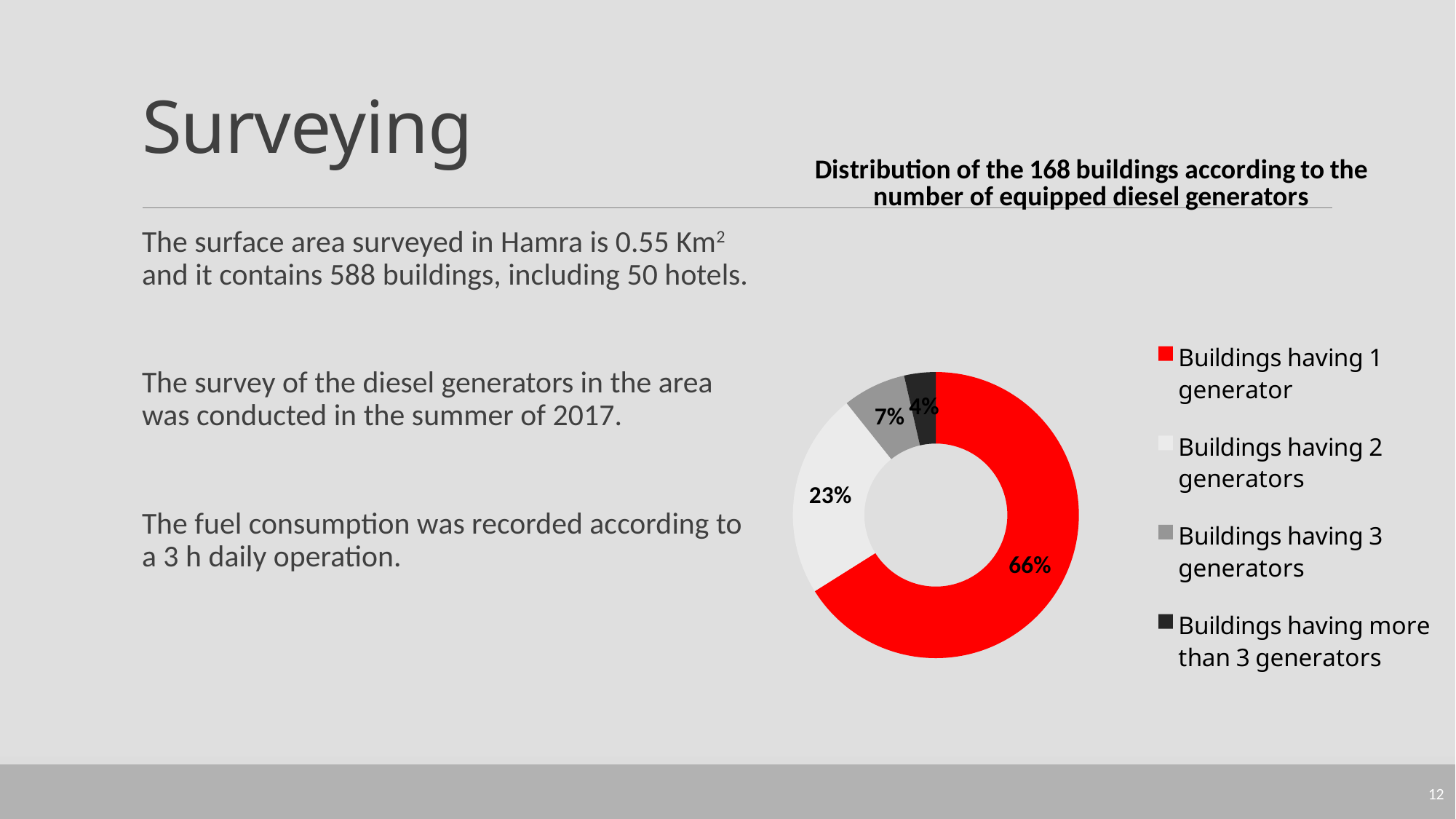
What share of the buildings have 1 generator? 66% What share of the buildings have 3 generators? 7% What colour represents buildings having 1 generator? Red Which category has the largest share of the buildings? Buildings having 1 generator What share of the buildings have 2 generators? 23% What is the difference in percentage points between buildings having 1 generator and buildings having 2 generators? 43 What is the title of the chart? Distribution of the 168 buildings according to the number of equipped diesel generators What share of the buildings have more than 3 generators? 4% What kind of chart is shown on the slide? Pie chart (doughnut) How many categories does the chart show? 4 Which is larger: the share of buildings having 3 generators or the share of buildings having more than 3 generators? Buildings having 3 generators Which category has the smallest share of the buildings? Buildings having more than 3 generators